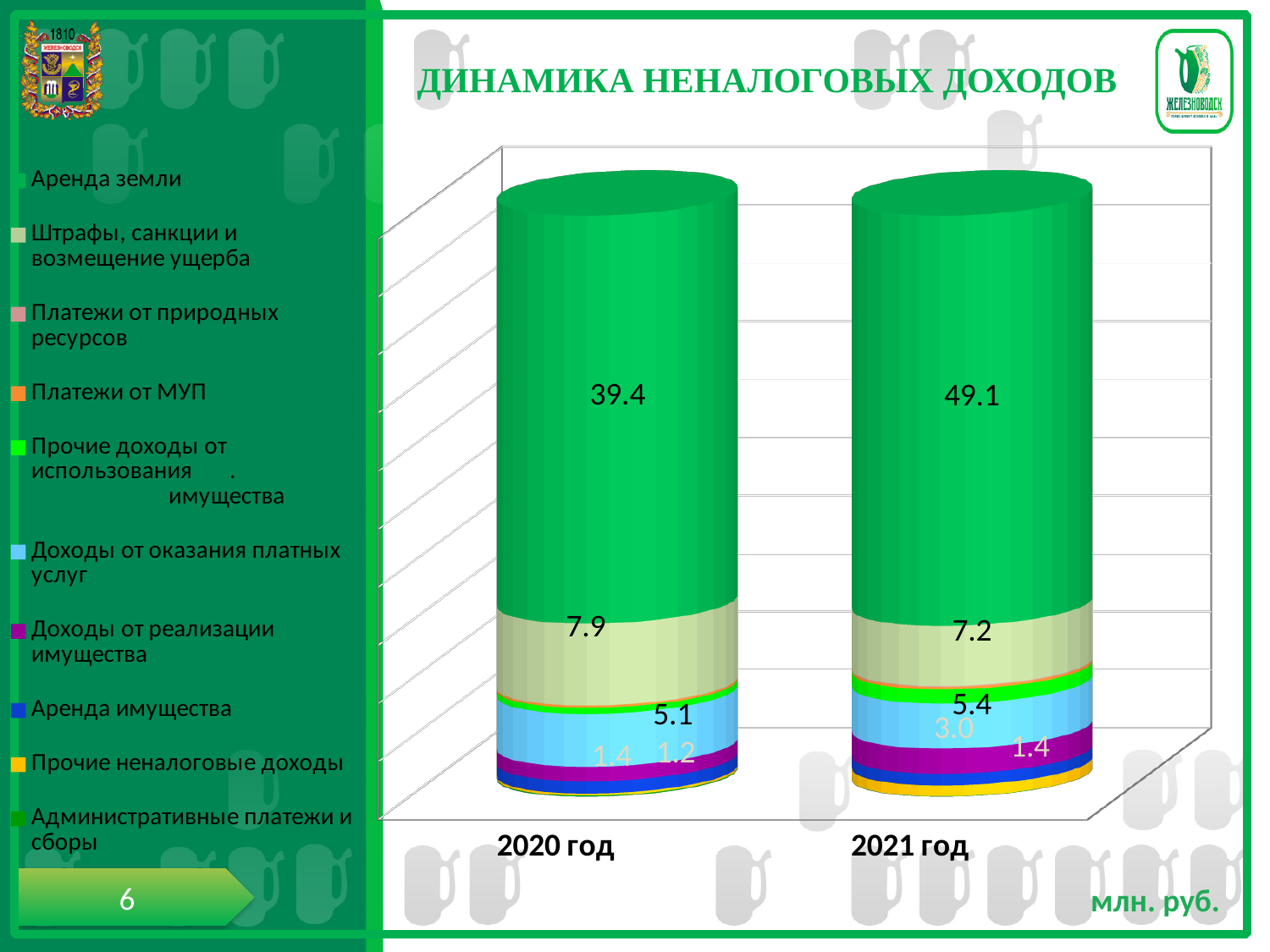
What is the value of the largest (top green) segment of the 2020 год bar? 39.4 By how much did the largest (top green) segment grow from 2020 год to 2021 год? 9.7 In which year is the Штрафы, санкции и возмещение ущерба segment larger, 2020 год or 2021 год? 2020 год How many years (categories) are shown on the x axis of the chart? 2 What kind of chart is shown on the slide? Stacked bar chart What is the title of the chart? ДИНАМИКА НЕНАЛОГОВЫХ ДОХОДОВ What is the value of the Штрафы, санкции и возмещение ущерба segment for 2021 год? 7.2 What is the value of the Штрафы, санкции и возмещение ущерба segment for 2020 год? 7.9 What is the value of the largest (top green) segment of the 2021 год bar? 49.1 What is the value of the Доходы от оказания платных услуг (light blue) segment for 2021 год? 5.4 How many series does the legend on the left of the chart list? 10 Does the largest (top green) segment rise or fall from 2020 год to 2021 год? Rises